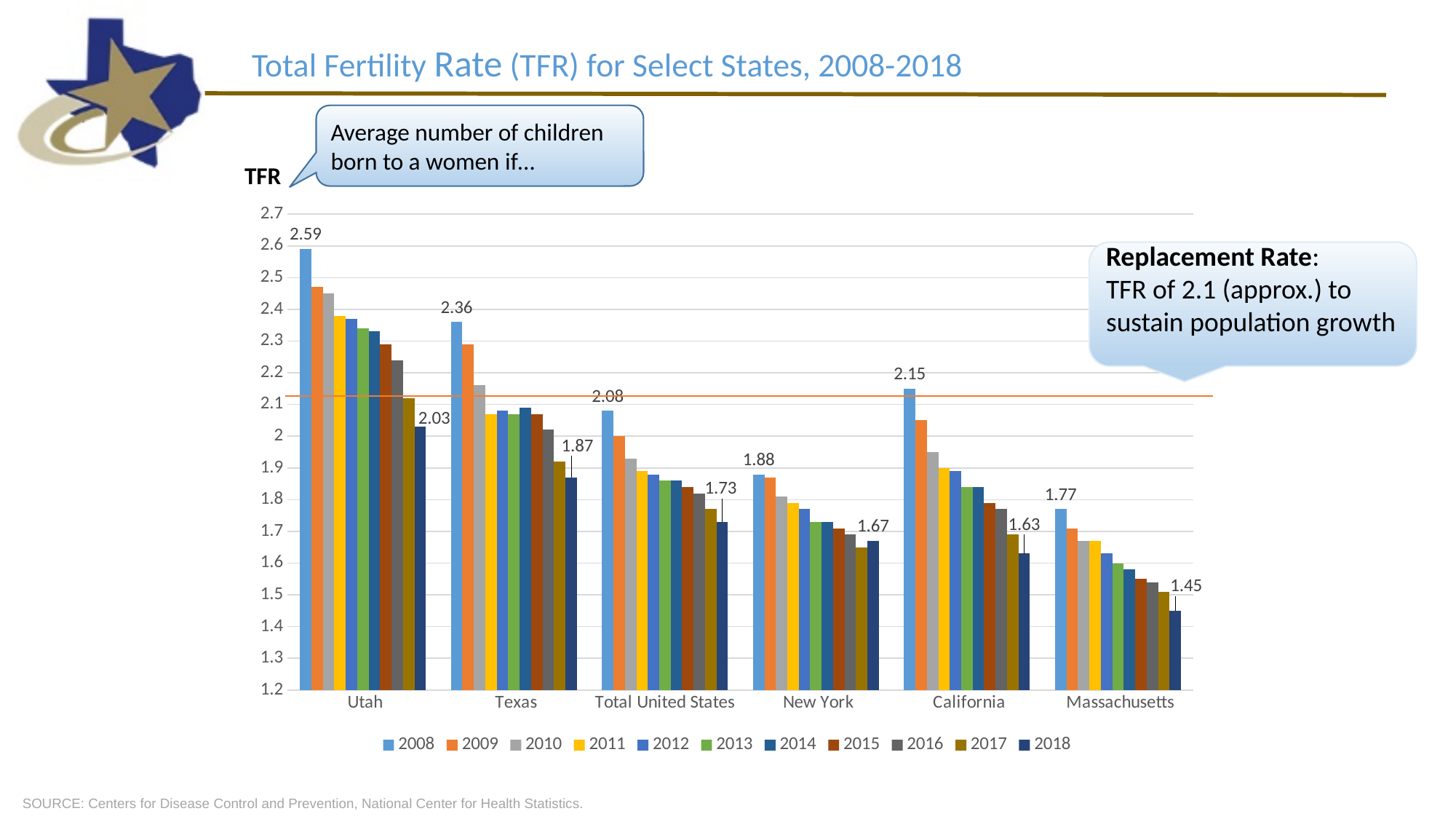
What was the Total Fertility Rate for Utah in 2008? 2.59 By how much did Utah's Total Fertility Rate fall from 2008 to 2018? 0.56 Is the 2010 Total Fertility Rate for Utah greater or less than 2.4? greater What was the Total Fertility Rate for California in 2008? 2.15 Does the Total Fertility Rate for Texas rise or fall from 2008 to 2018? fall Which was higher in 2008, the Total Fertility Rate for New York or for Massachusetts? New York Which category had the lowest Total Fertility Rate in 2018? Massachusetts What was the Total Fertility Rate for Texas in 2018? 1.87 What was the Total Fertility Rate for Massachusetts in 2018? 1.45 What is the difference between the 2018 Total Fertility Rate for Texas and for the Total United States? 0.14 How many series does the legend list? 11 Which state had the highest Total Fertility Rate in 2008? Utah